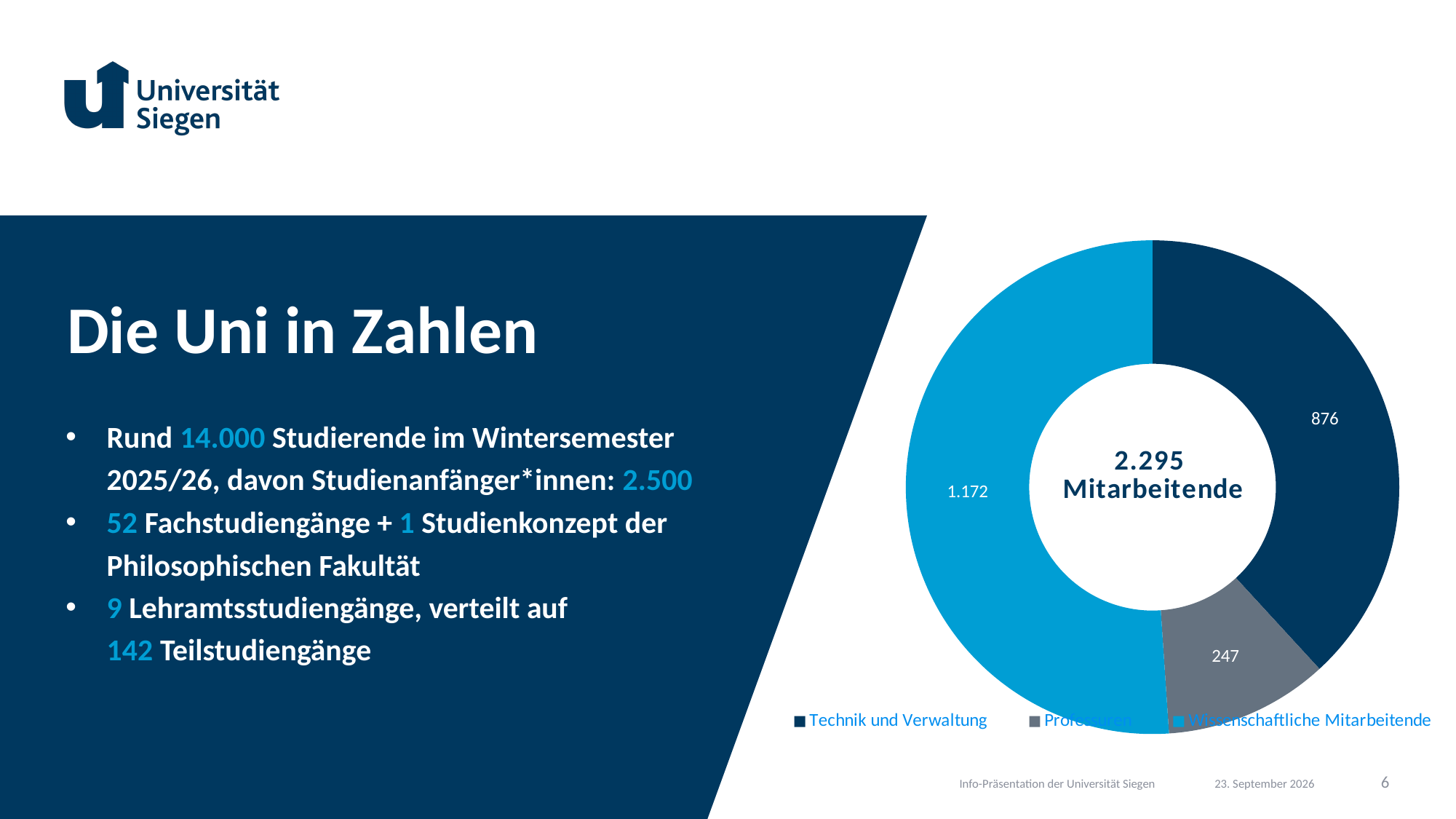
What value is shown for Wissenschaftliche Mitarbeitende in the donut chart? 1.172 What kind of chart is shown on the slide? Pie (donut) chart What is the difference between the values for Wissenschaftliche Mitarbeitende and Technik und Verwaltung? 296 What total is printed in the centre of the donut chart? 2.295 Mitarbeitende What is the difference between the values for Technik und Verwaltung and Professuren? 629 What value is shown for Professuren in the donut chart? 247 Which is larger: Technik und Verwaltung or Professuren? Technik und Verwaltung How many categories does the donut chart show? 3 What value is shown for Technik und Verwaltung in the donut chart? 876 Which colour represents Professuren in the donut chart? Grey Which category has the largest slice in the donut chart? Wissenschaftliche Mitarbeitende Which category has the smallest slice in the donut chart? Professuren